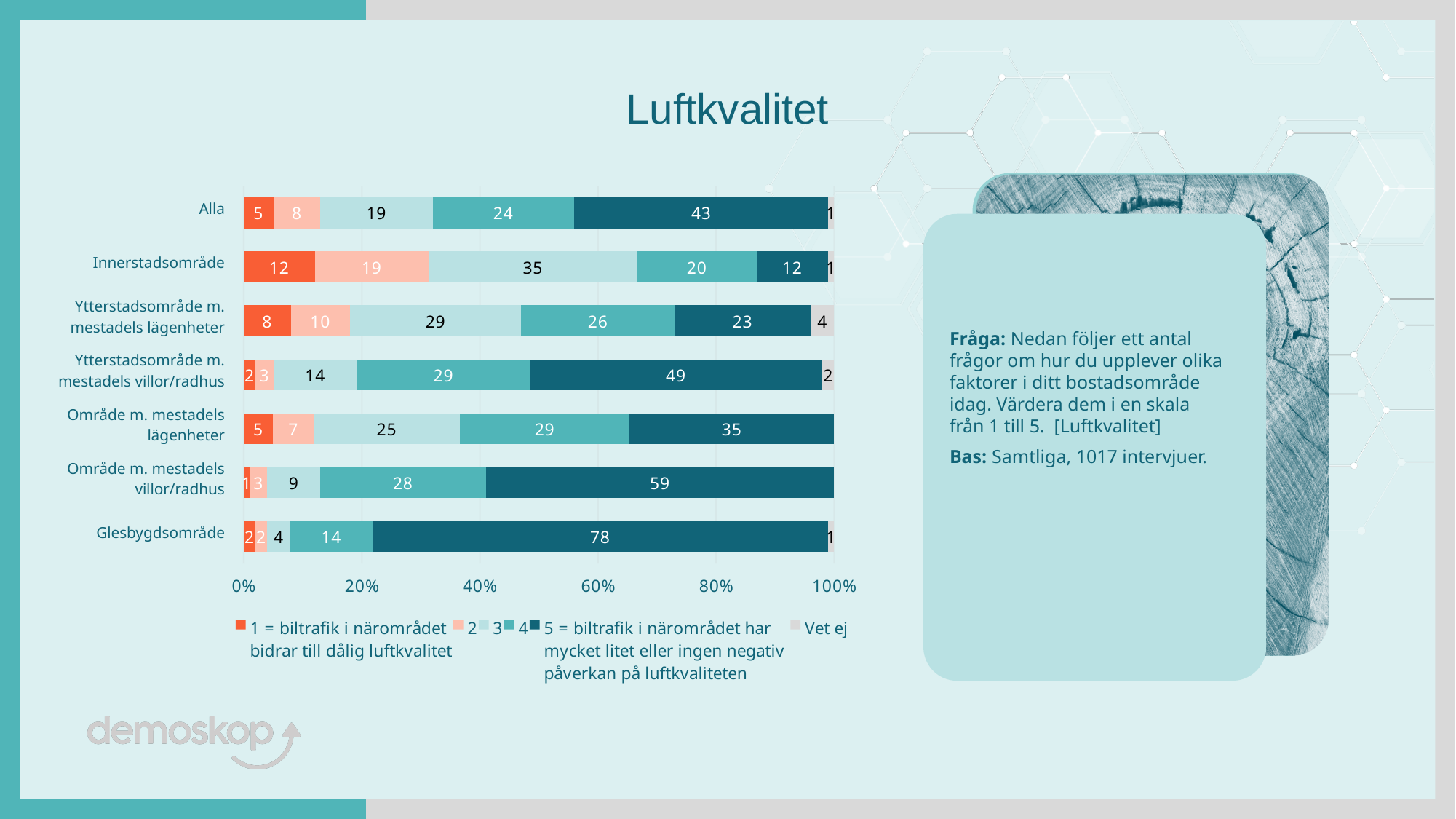
How many categories (rows) are shown in the chart? 7 Which category has the highest value for series 5? Glesbygdsområde Which has a larger series 1 value, Innerstadsområde or Ytterstadsområde m. mestadels lägenheter? Innerstadsområde What is the title of the chart? Luftkvalitet What type of chart is shown on the slide? Stacked bar chart What is the difference between the series 5 values for Glesbygdsområde and Innerstadsområde? 66 What is the value of series 3 for Innerstadsområde? 35 What is the value of series 5 for Glesbygdsområde? 78 How many series does the legend list? 6 What is the total of all labelled segments in the Alla bar? 100 Which category has the lowest value for series 5? Innerstadsområde What is the value of series 1 for Alla? 5